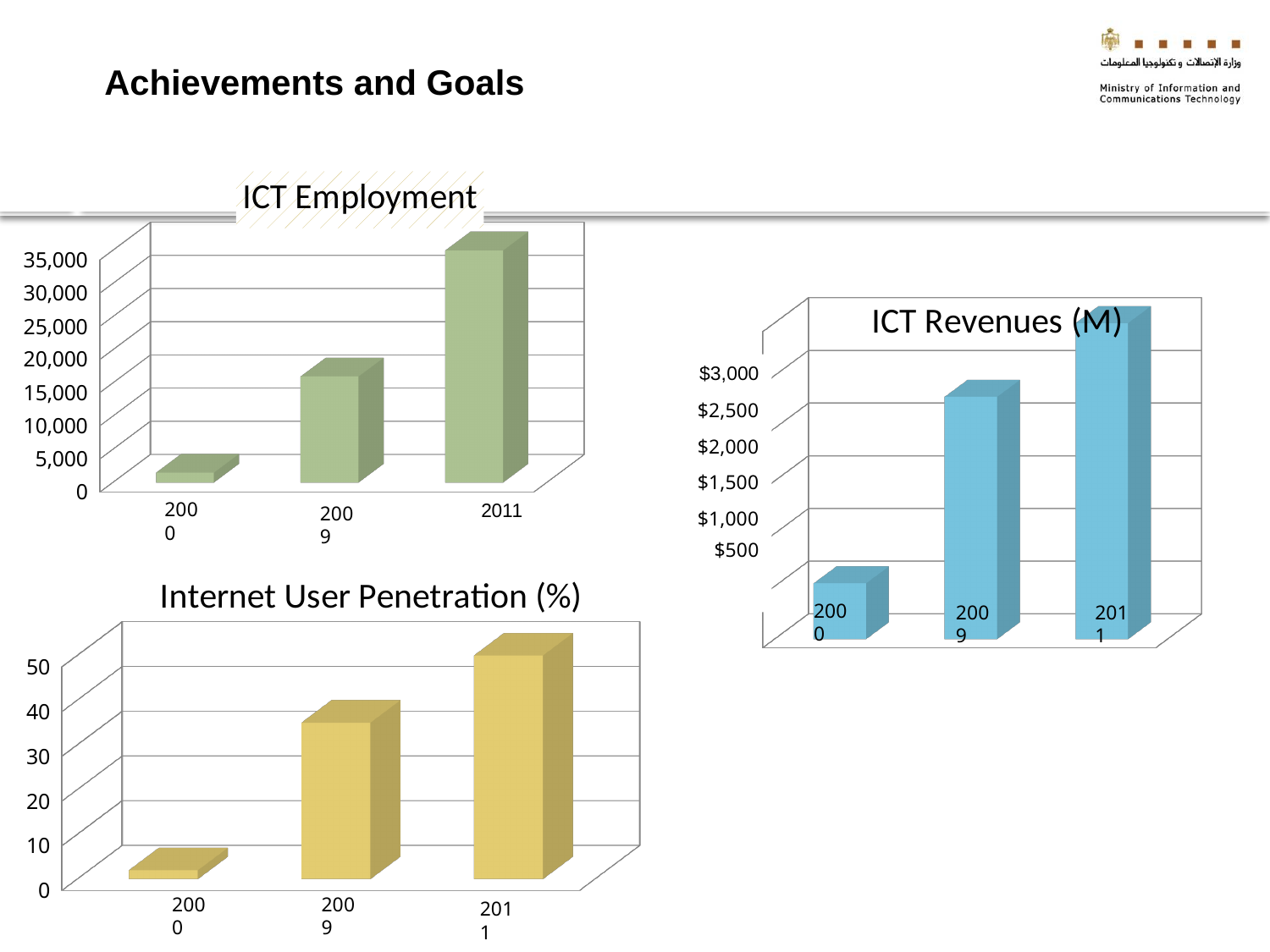
In the ICT Revenues (M) chart, which year has the highest revenue? 2011 In the Internet User Penetration (%) chart, which is larger, the value for 2000 or the value for 2011? 2011 In the Internet User Penetration (%) chart, is the value for 2009 greater or less than 30? greater In the ICT Employment chart, is the value for 2009 greater or less than 10,000? greater In the ICT Employment chart, is the value for 2000 greater or less than 5,000? less How many years are shown in the ICT Revenues (M) chart? 3 In the ICT Employment chart, which year has the lowest value? 2000 In the ICT Employment chart, which year has the highest value? 2011 What kind of chart is the Internet User Penetration (%) chart? bar chart In the Internet User Penetration (%) chart, do the values rise or fall from 2000 to 2011? rise